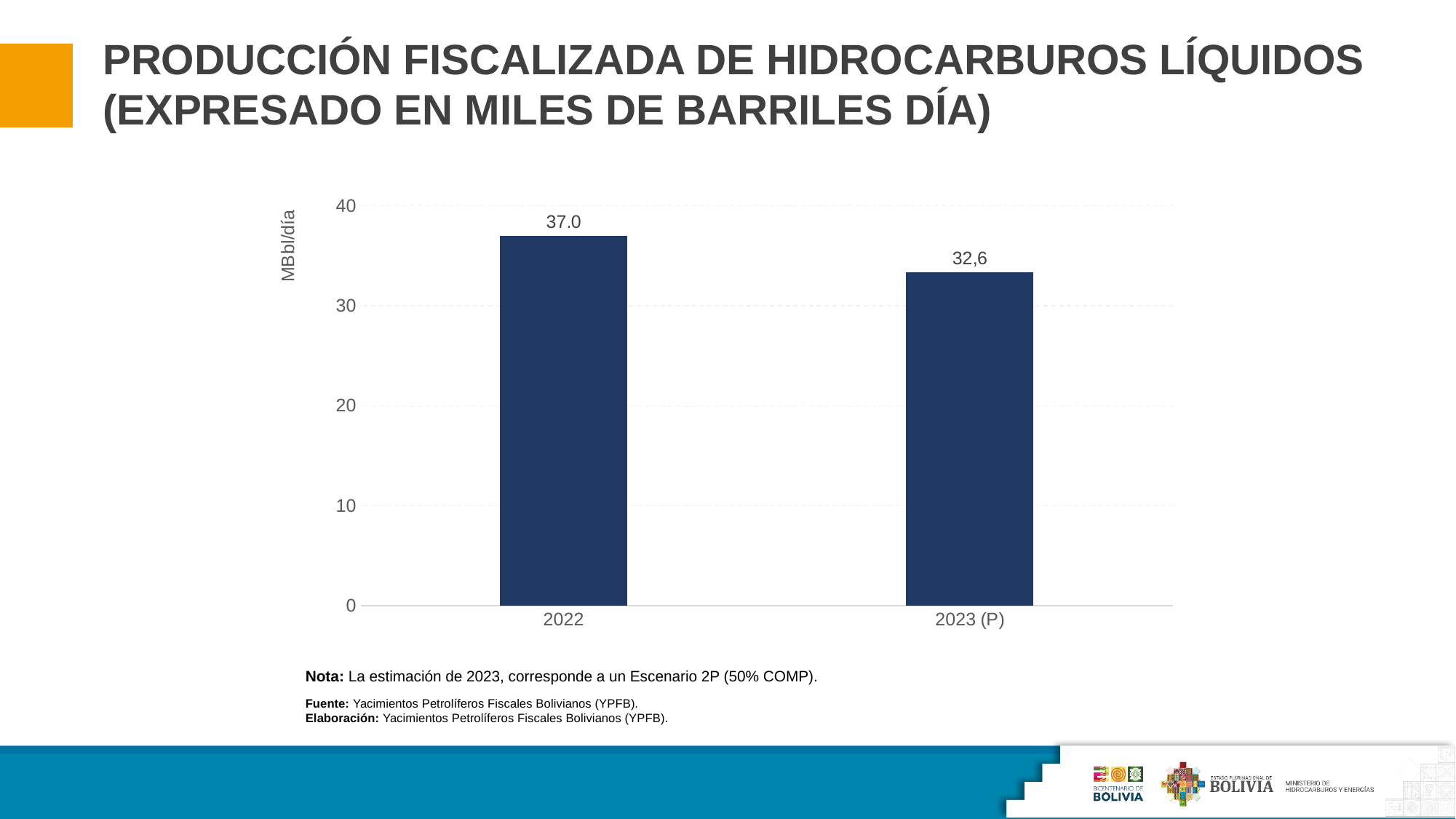
How many categories are shown on the x axis? 2 What is the value for 2022? 37.0 Is the value for 2023 (P) greater or less than 30? greater Do the values rise or fall from 2022 to 2023 (P)? fall What kind of chart is shown on the slide? bar chart What unit is shown on the y axis label? MBbl/día What is the value for 2023 (P)? 32,6 Which category has the highest value? 2022 What is the difference between the values for 2022 and 2023 (P)? 4.4 Which category has the lowest value? 2023 (P) Which is larger, the value for 2022 or the value for 2023 (P)? 2022 Is the value for 2022 greater or less than 40? less